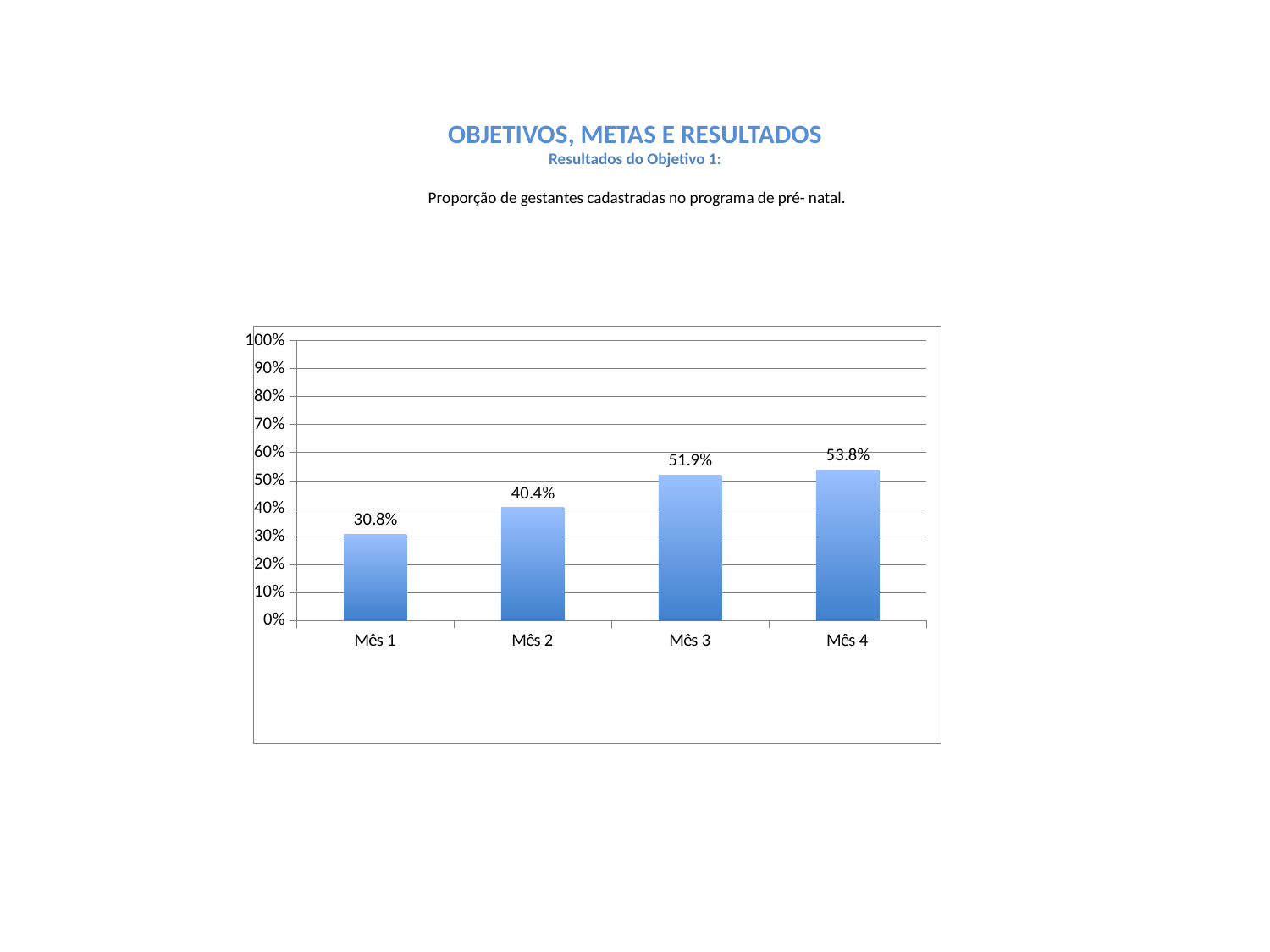
Which month has the highest value? Mês 4 Do the values rise or fall from Mês 1 to Mês 4? rise Which month has the lowest value? Mês 1 What kind of chart is shown on the slide? bar chart Is the value for Mês 2 greater or less than 50%? less What is the difference between the values for Mês 2 and Mês 1? 9.6% Which is larger, the value for Mês 2 or the value for Mês 3? Mês 3 What is the difference between the values for Mês 4 and Mês 3? 1.9% What is the value for Mês 4? 53.8% What is the value for Mês 1? 30.8% What is the value for Mês 3? 51.9% How many months are shown on the x axis? 4